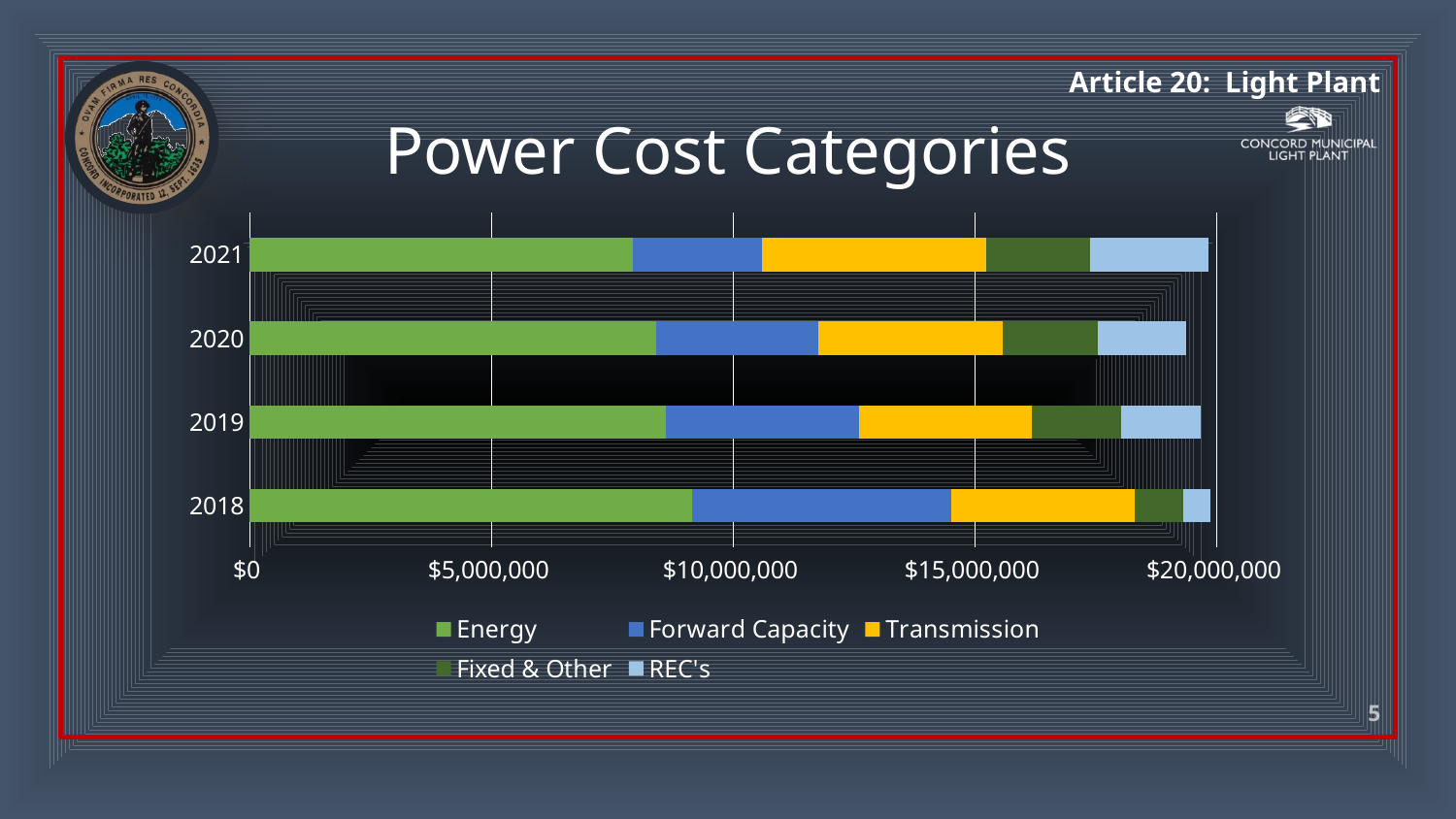
Is the Forward Capacity segment larger in 2018 or in 2021? 2018 Which year has the smallest REC's segment? 2018 Is the Energy value for 2018 greater or less than $10,000,000? less Does the REC's segment rise or fall from 2018 to 2021? rise What kind of chart is shown on the slide? Stacked bar chart Which colour represents Energy in the chart? Green Which year has the largest Energy segment? 2018 How many series does the legend list? 5 Is the total power cost for 2020 greater or less than $15,000,000? greater How many years are plotted on the chart? 4 What is the title of the chart? Power Cost Categories Is the Energy value for 2021 greater or less than $5,000,000? greater